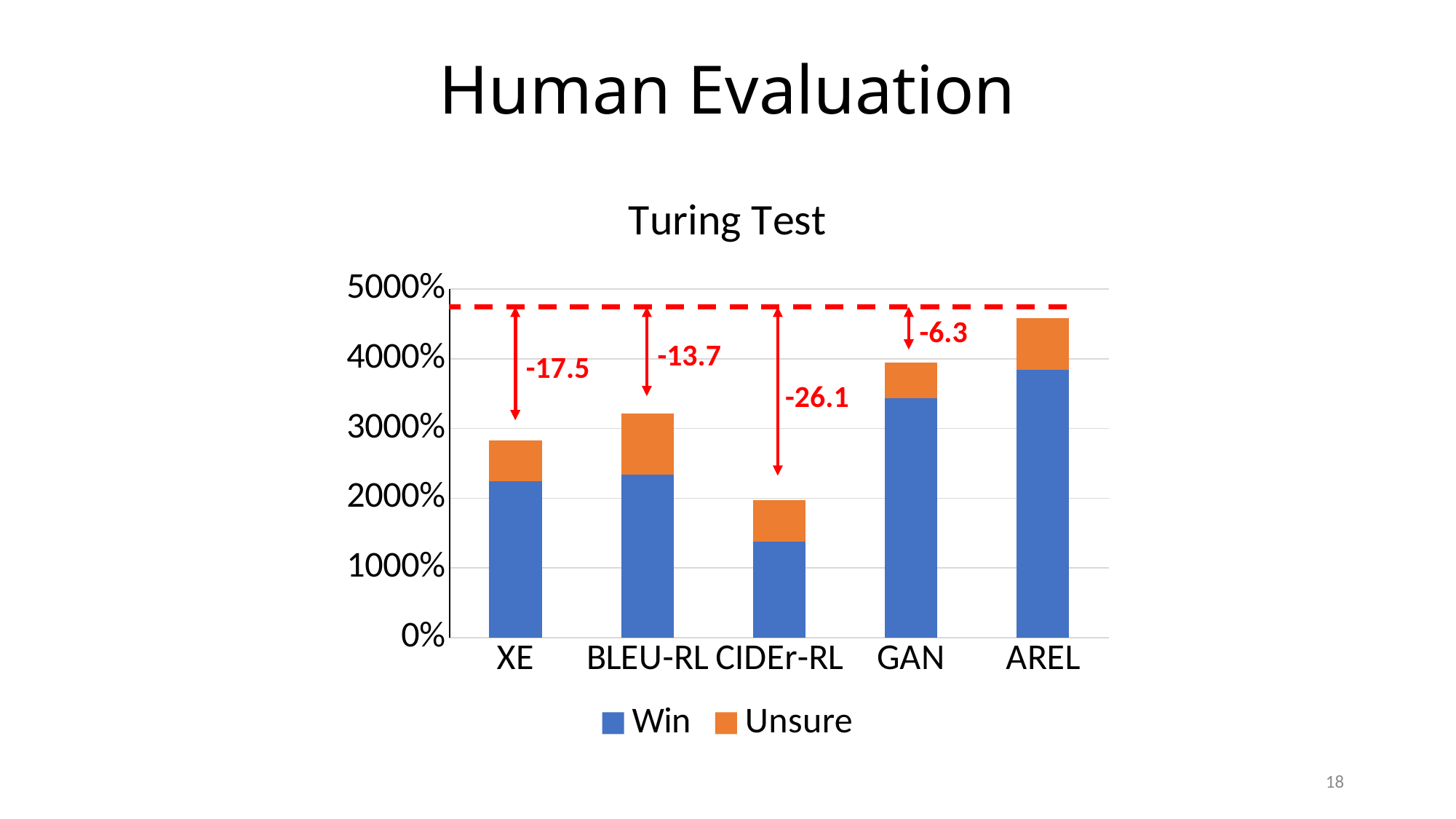
Which category has the shortest stacked bar? CIDEr-RL Which category has the tallest stacked bar? AREL How many series does the legend list? 2 What kind of chart is shown on the slide? stacked bar chart How many categories are shown on the x axis? 5 Is the total stacked value for XE greater or less than 2000%? greater Which has the larger total stacked bar, GAN or XE? GAN What is the title of the chart? Turing Test Is the total stacked value for AREL greater or less than 4000%? greater What red annotation value is printed above the CIDEr-RL bar? -26.1 Is the Win value for CIDEr-RL greater or less than 2000%? less